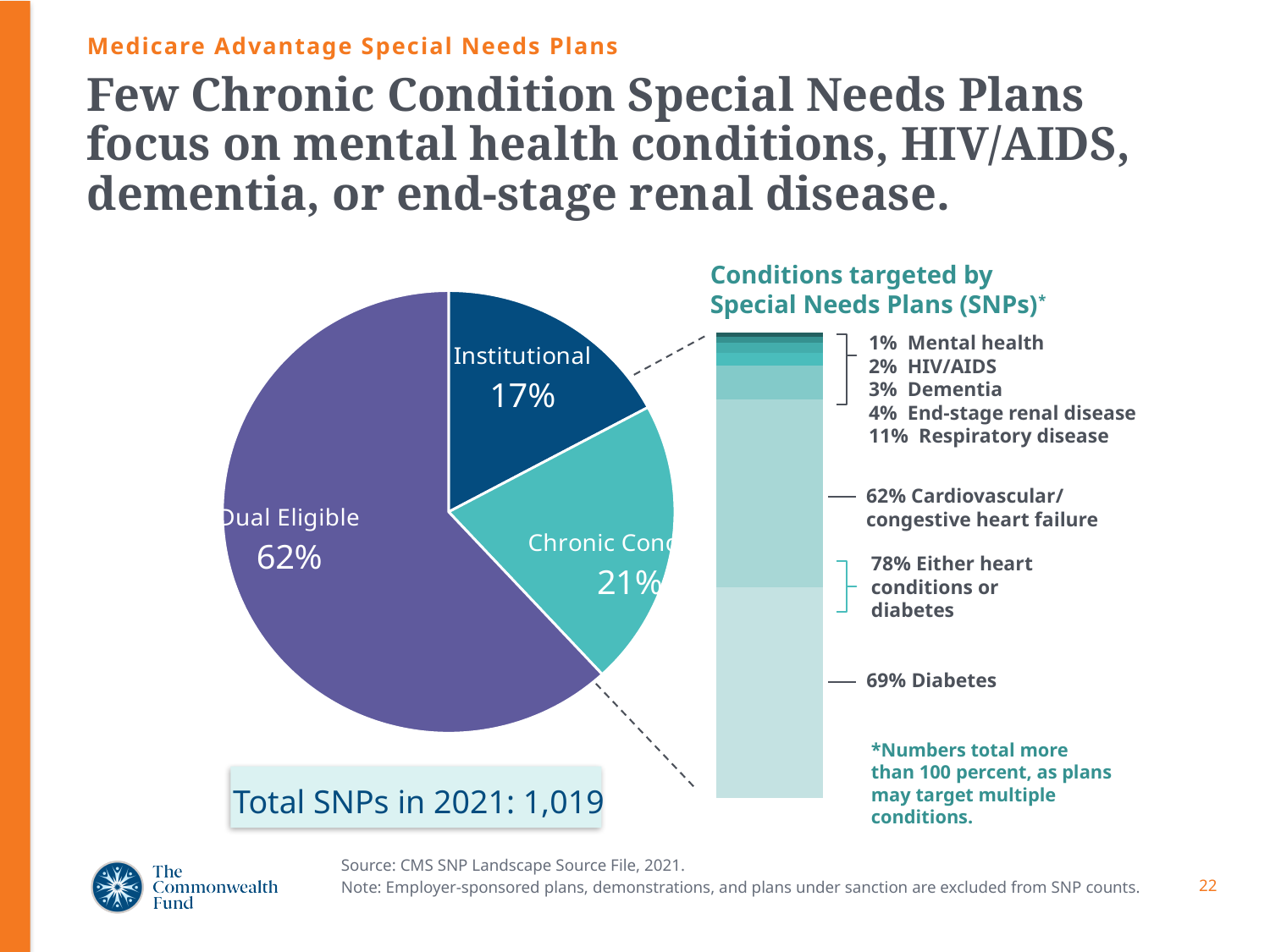
In the pie chart, what share of Special Needs Plans are Chronic Condition plans? 21% In the pie chart, which category has the smallest share? Institutional In the pie chart, what is the difference in percentage points between the Dual Eligible and Chronic Condition shares? 41 In the pie chart, what share of Special Needs Plans are Dual Eligible? 62% How many slices does the pie chart have? 3 In the 'Conditions targeted by Special Needs Plans' bar, what percentage of plans target mental health? 1% In the pie chart, which category has the largest share? Dual Eligible According to the slide, what was the total number of SNPs in 2021? 1,019 In the 'Conditions targeted by Special Needs Plans' bar, what percentage of plans target diabetes? 69% In the pie chart, which is larger: the Institutional share or the Chronic Condition share? Chronic Condition What type of chart shows the breakdown of Dual Eligible, Institutional, and Chronic Condition plans? Pie chart In the pie chart, what share of Special Needs Plans are Institutional? 17%